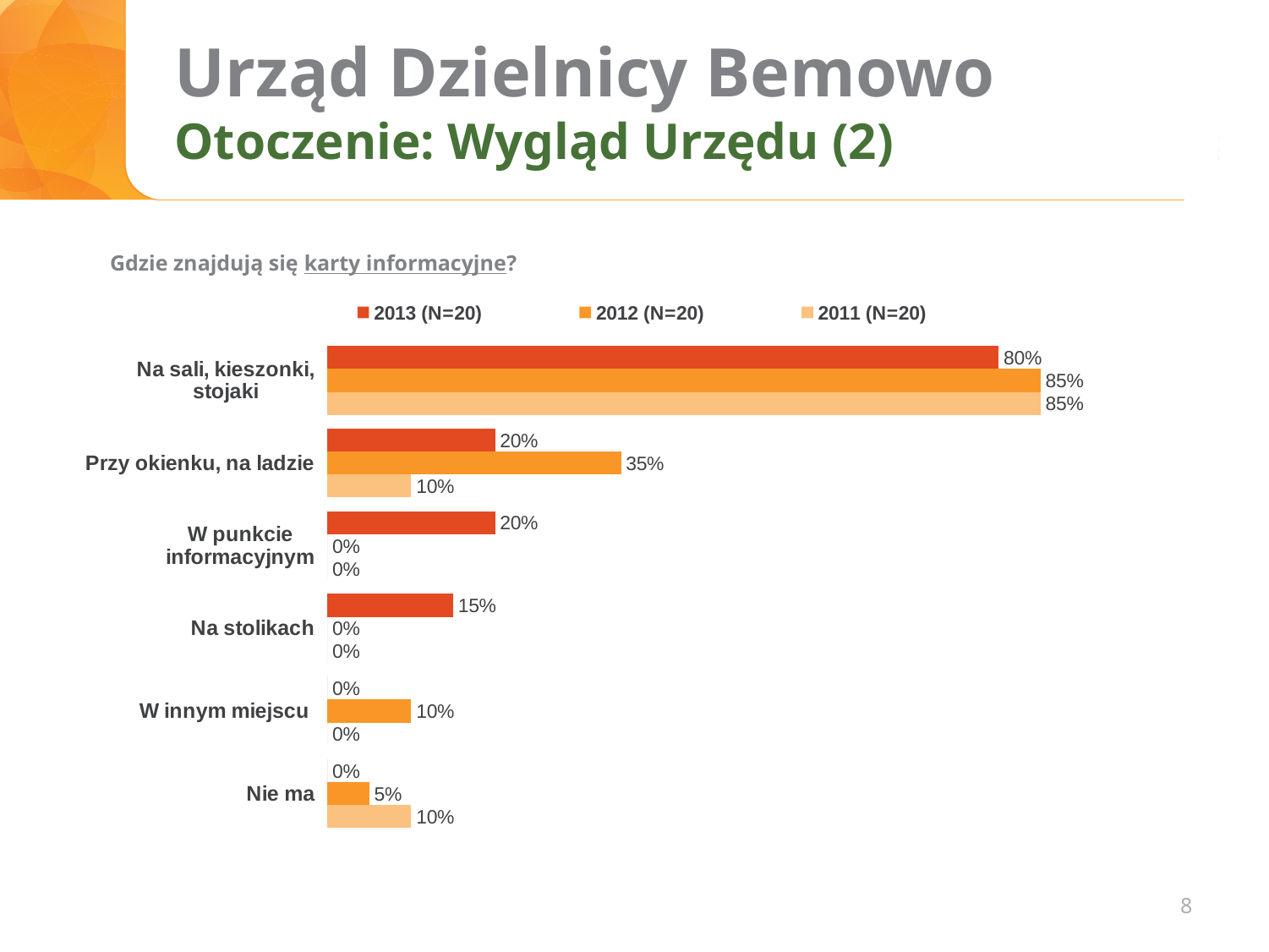
Which is larger for 'W innym miejscu': the 2012 (N=20) value or the 2013 (N=20) value? 2012 (N=20) What is the difference between the 2013 (N=20) and 2012 (N=20) values for 'Na sali, kieszonki, stojaki'? 5% What is the value for 'Przy okienku, na ladzie' in the 2012 (N=20) series? 35% How many categories are shown on the chart? 6 What is the value for 'Na sali, kieszonki, stojaki' in the 2013 (N=20) series? 80% What question is the chart answering, as written above it? Gdzie znajdują się karty informacyjne? What kind of chart is shown on the slide? Bar chart How many series does the legend list? 3 Which category has the highest value in the 2012 (N=20) series? Na sali, kieszonki, stojaki What is the difference between the 2012 (N=20) and 2011 (N=20) values for 'Przy okienku, na ladzie'? 25% What is the value for 'Nie ma' in the 2011 (N=20) series? 10% What is the value for 'Na stolikach' in the 2013 (N=20) series? 15%